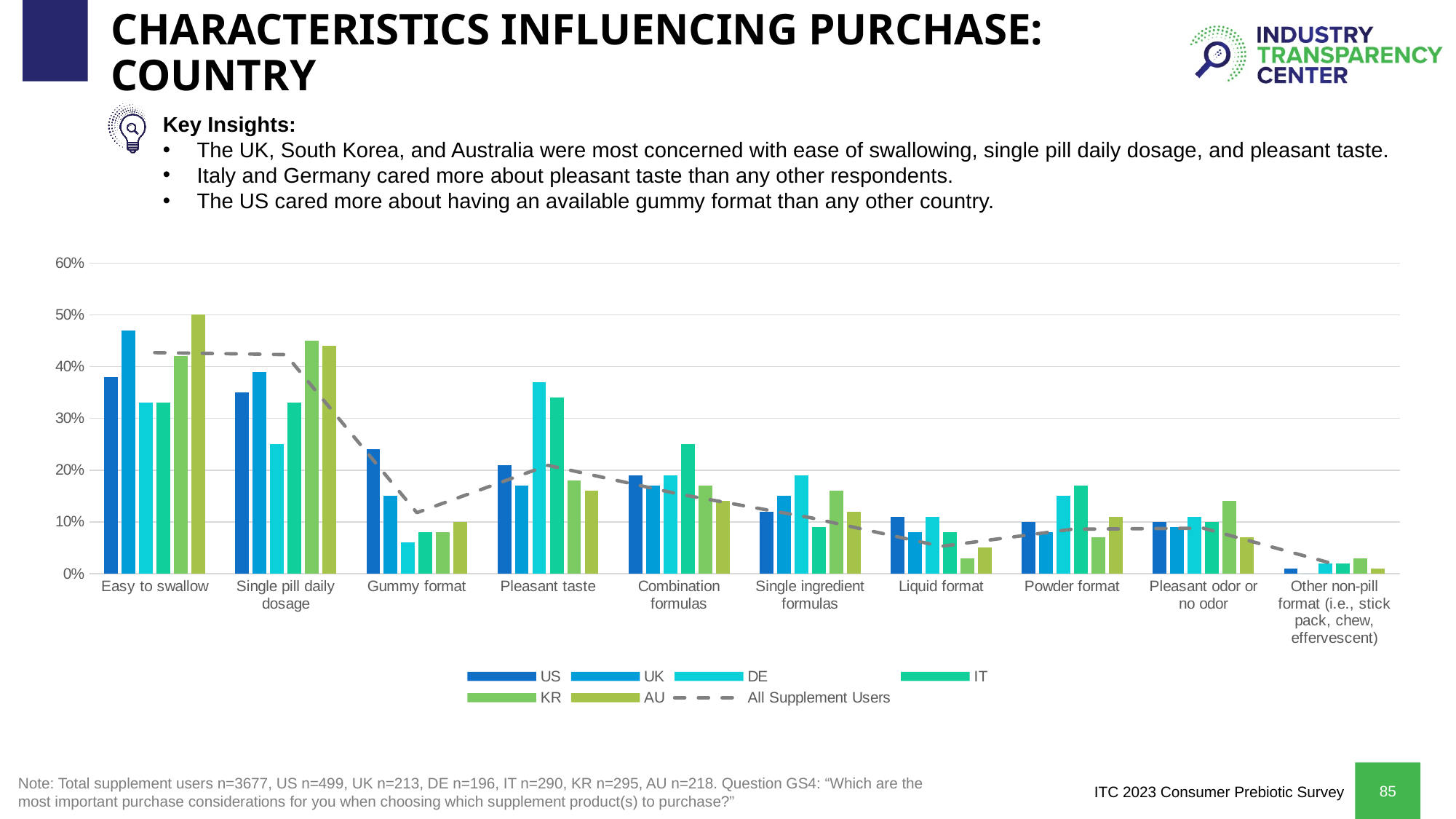
Does the All Supplement Users dashed line generally rise or fall from left to right across the categories? fall Is the US value for Gummy format greater or less than 20%? greater Is the KR value for Liquid format greater or less than 10%? less For Combination formulas, which is larger, the IT value or the KR value? IT What kind of chart is shown on the slide? combination bar and line chart How many entries does the legend list? 7 Is the DE value for Pleasant taste greater or less than 30%? greater Which country has the lowest value for Liquid format? KR Which country has the highest value for Gummy format? US How many purchase characteristics (categories) are shown on the x axis? 10